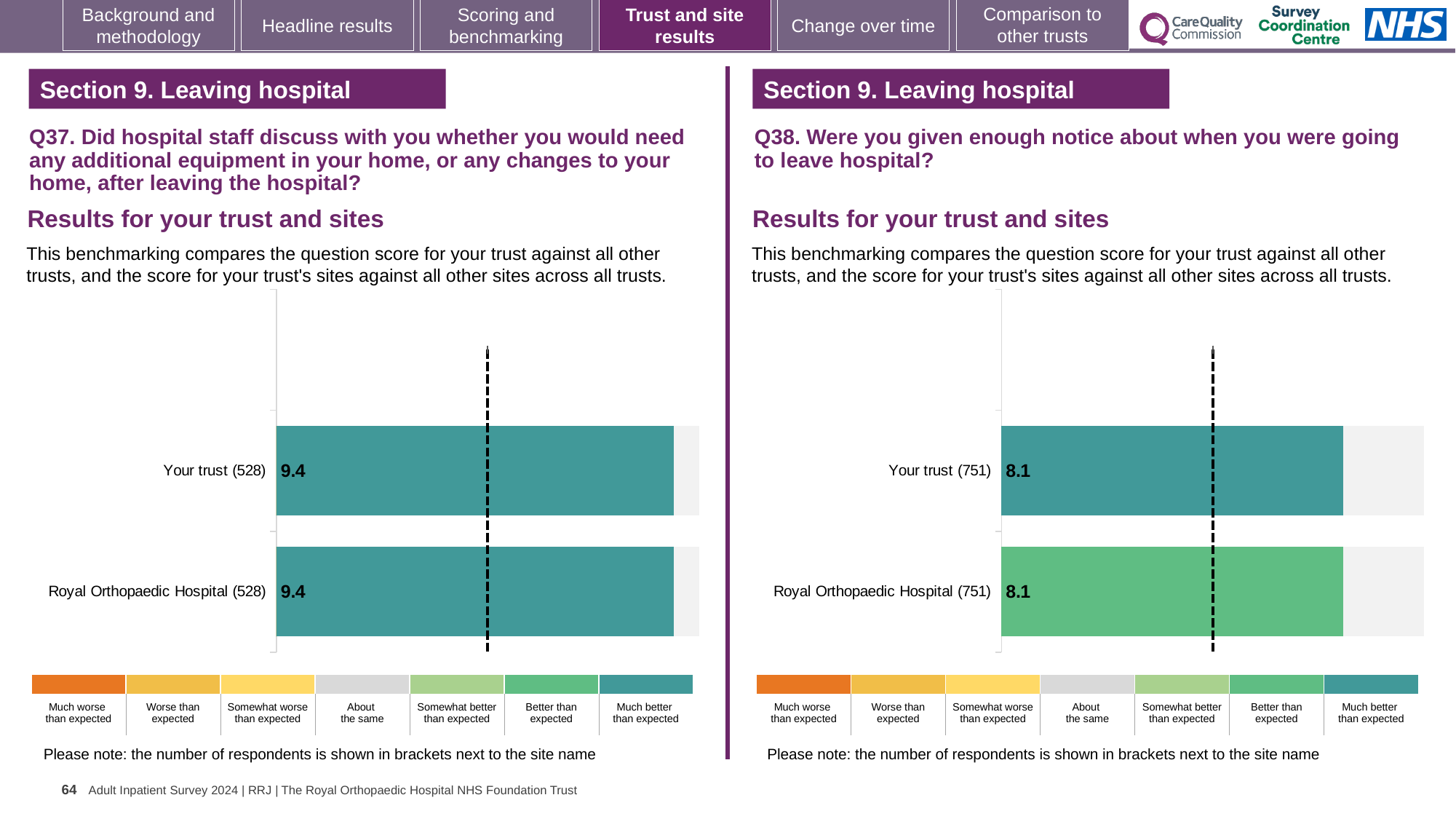
How many bars are plotted in the Q37 chart on the left? 2 In the Q38 chart on the right, what is the score for Your trust? 8.1 How many bars are plotted in the Q38 chart on the right? 2 In the Q38 chart on the right, how many respondents are shown in brackets next to Royal Orthopaedic Hospital? 751 What kind of chart is the Q38 chart on the right? Bar chart In the Q37 chart on the left, how many respondents are shown in brackets next to Your trust? 528 In the Q37 chart on the left, what is the score for Royal Orthopaedic Hospital? 9.4 In the Q38 chart on the right, what is the difference between the score for Your trust and the score for Royal Orthopaedic Hospital? 0.0 In the Q38 chart on the right, which benchmark category does the colour of the Royal Orthopaedic Hospital bar correspond to in the legend? Better than expected In the Q38 chart on the right, what is the score for Royal Orthopaedic Hospital? 8.1 In the Q37 chart on the left, what is the difference between the score for Your trust and the score for Royal Orthopaedic Hospital? 0.0 In the Q37 chart on the left, what is the score for Your trust? 9.4